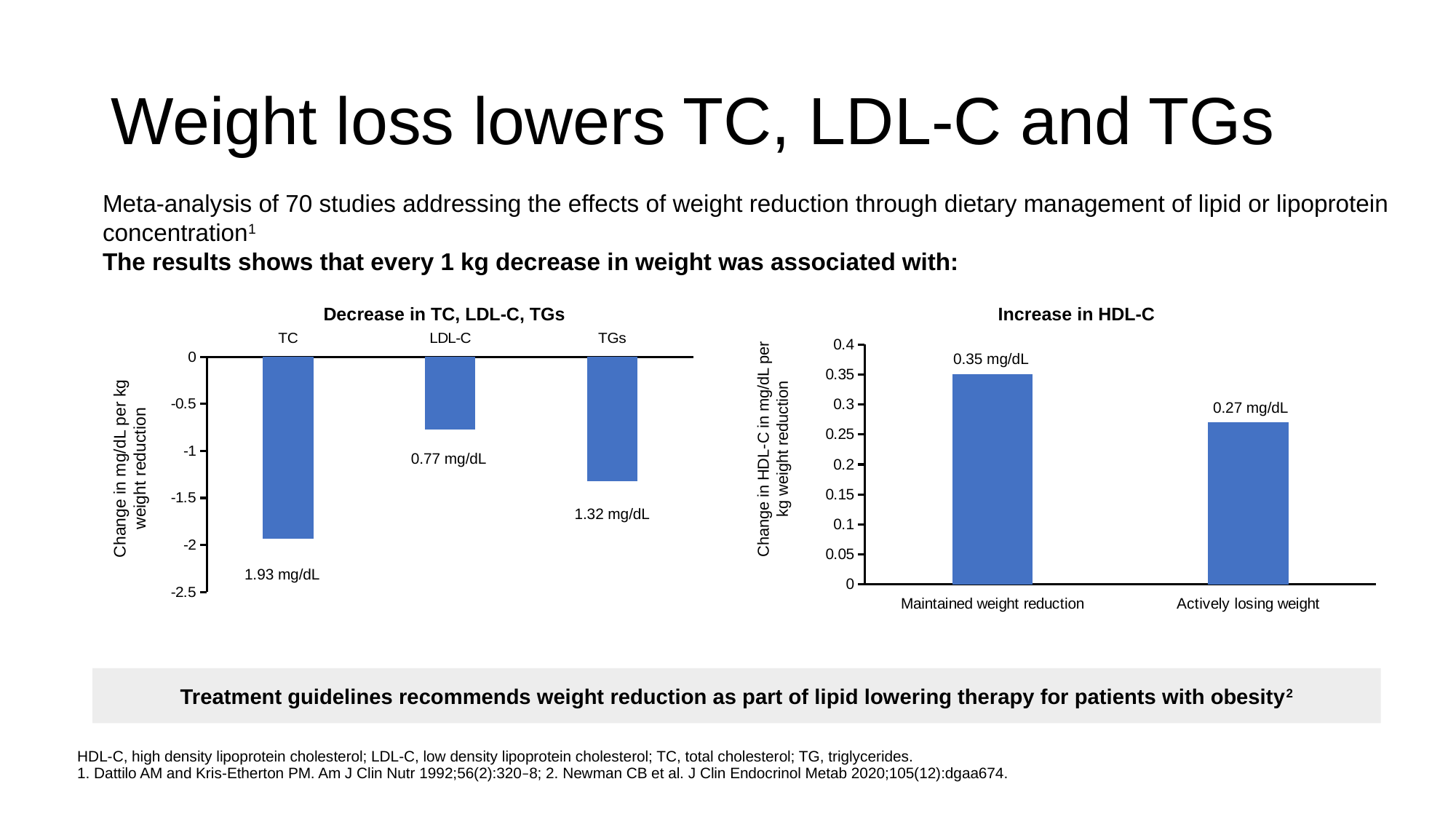
In the 'Increase in HDL-C' chart, what is the value for Maintained weight reduction? 0.35 mg/dL In the 'Decrease in TC, LDL-C, TGs' chart, what is the data label for TC? 1.93 mg/dL In the 'Decrease in TC, LDL-C, TGs' chart, what is the data label for LDL-C? 0.77 mg/dL In the 'Increase in HDL-C' chart, what is the difference between the two values? 0.08 mg/dL In the 'Decrease in TC, LDL-C, TGs' chart, how many categories are plotted? 3 In the 'Decrease in TC, LDL-C, TGs' chart, what is the difference between the labelled values for TC and LDL-C? 1.16 mg/dL In the 'Decrease in TC, LDL-C, TGs' chart, which category shows the largest decrease? TC In the 'Increase in HDL-C' chart, what is the value for Actively losing weight? 0.27 mg/dL In the 'Decrease in TC, LDL-C, TGs' chart, which category shows the smallest decrease? LDL-C In the 'Decrease in TC, LDL-C, TGs' chart, what is the data label for TGs? 1.32 mg/dL In the 'Increase in HDL-C' chart, which category has the higher value? Maintained weight reduction What kind of chart is the 'Increase in HDL-C' chart? Bar chart